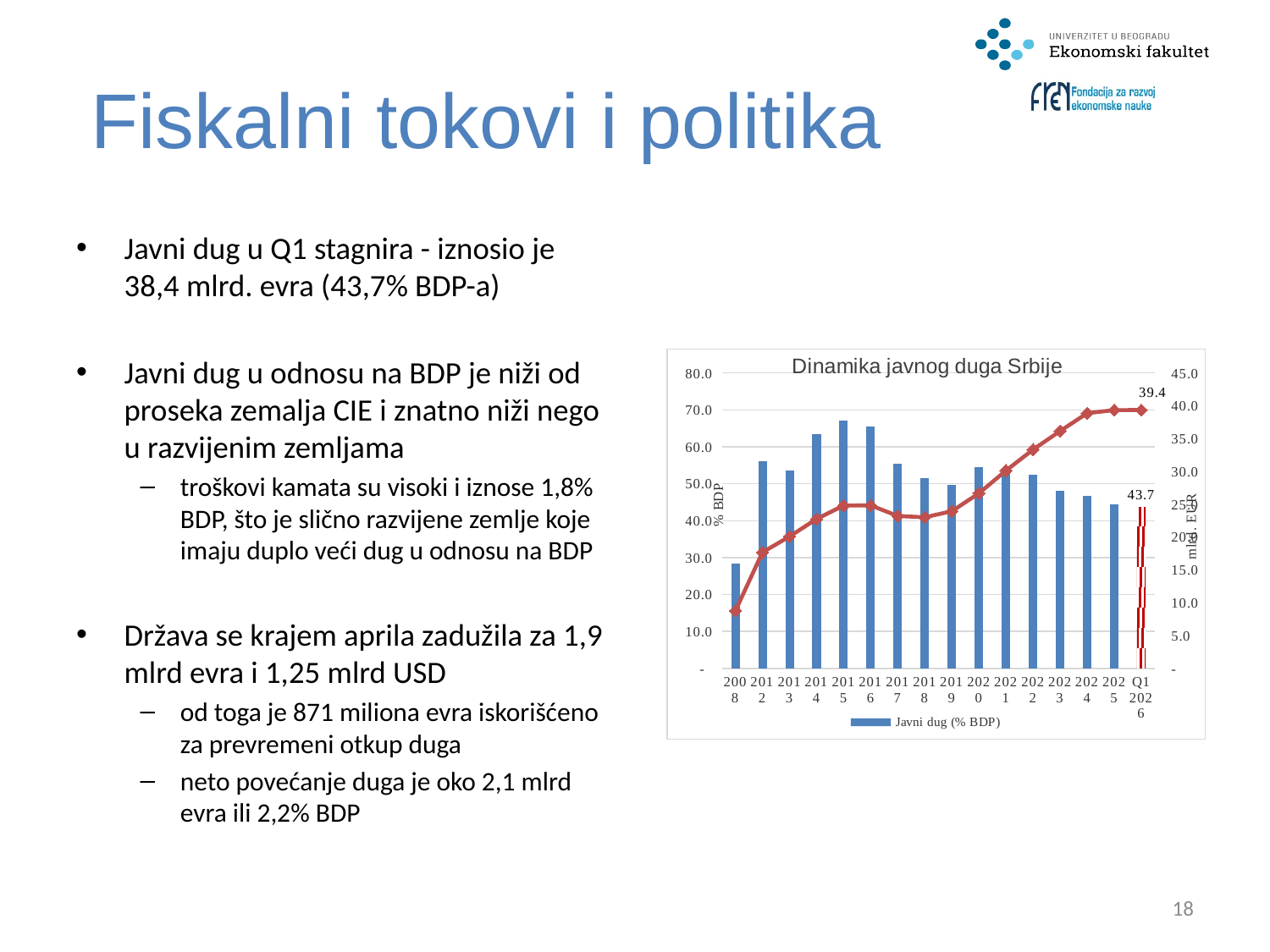
Is the bar for Javni dug (% BDP) in 2008 greater or less than 40? less Which year has the larger bar for Javni dug (% BDP), 2012 or 2013? 2012 Is the bar for Javni dug (% BDP) in 2015 greater or less than 60? greater What is the value of Javni dug (% BDP) for Q1 2026? 43.7 Is the bar for Javni dug (% BDP) in 2024 greater or less than 50? less Which year has the highest bar for Javni dug (% BDP)? 2015 Does the line series (mlrd. EUR) generally rise or fall from 2008 to Q1 2026? rise What kind of chart is used to show Javni dug (% BDP)? bar chart What is the title of the chart? Dinamika javnog duga Srbije What is the value of the line series (mlrd. EUR) for Q1 2026? 39.4 Which year has the lowest bar for Javni dug (% BDP)? 2008 How many categories are shown on the x axis? 16